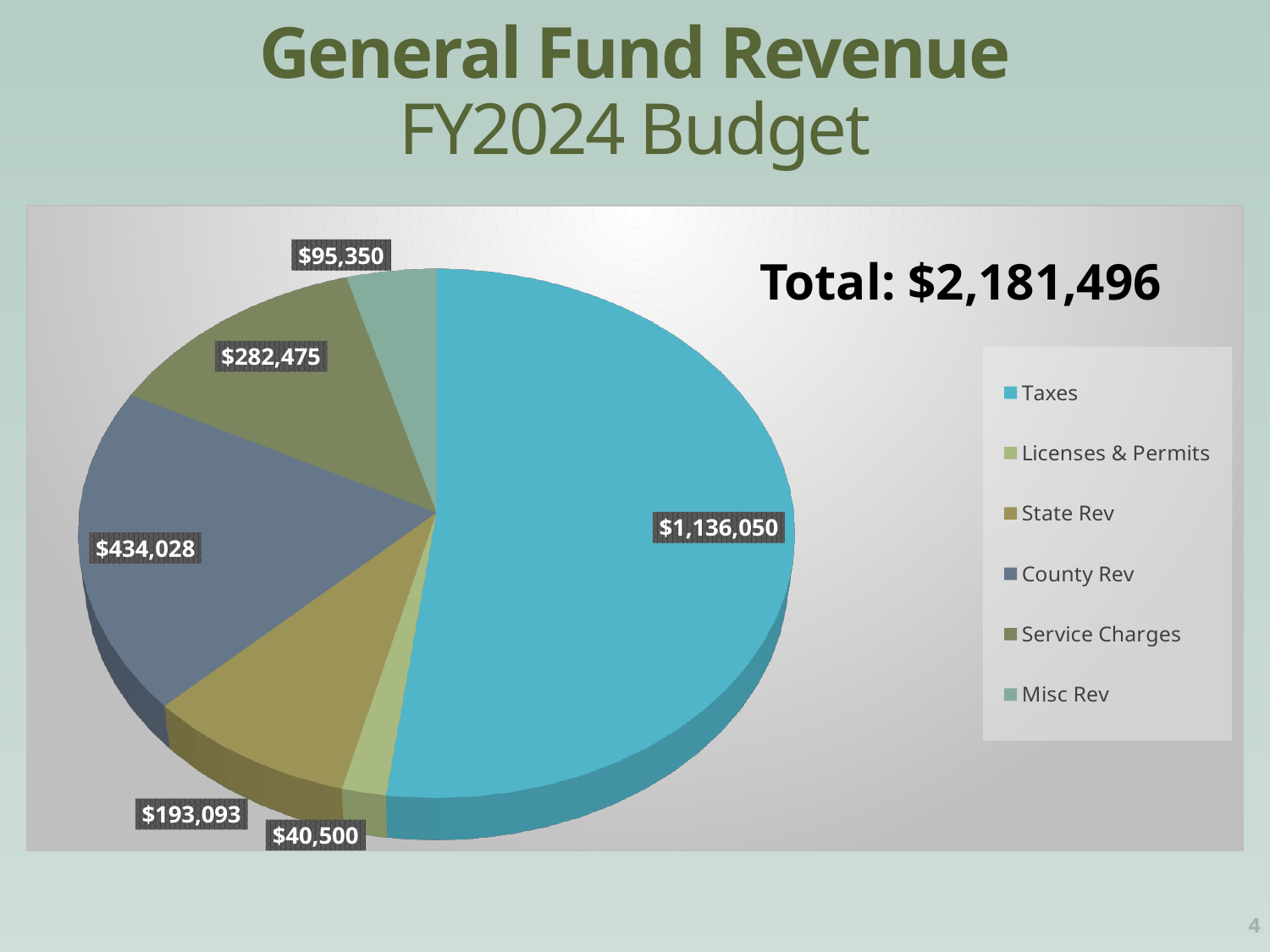
What type of chart is shown on the slide? Pie chart What is the value of the County Rev slice? $434,028 What is the difference between the Taxes value and the County Rev value? $702,022 What is the difference between the Service Charges value and the State Rev value? $89,382 What is the value of the Licenses & Permits slice? $40,500 What is the value of the Misc Rev slice? $95,350 Which revenue category has the largest slice? Taxes What is the value of the Taxes slice? $1,136,050 Which is larger, County Rev or Service Charges? County Rev How many categories does the pie chart show? 6 What total is printed on the chart? $2,181,496 Which revenue category has the smallest slice? Licenses & Permits